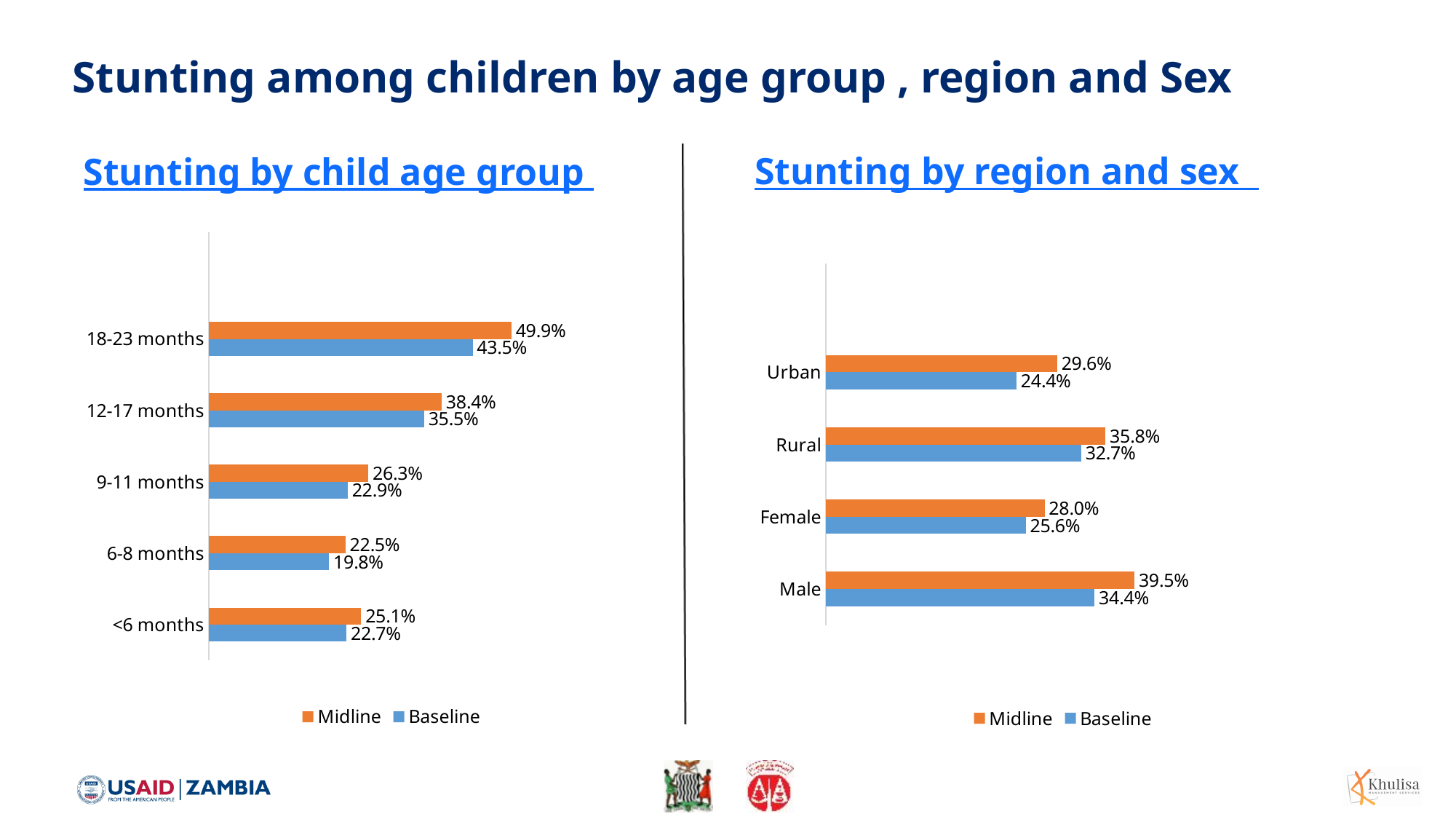
In the 'Stunting by region and sex' chart, what is the difference between the Midline and Baseline values for Male? 5.1% In the 'Stunting by region and sex' chart, what is the Midline value for Rural? 35.8% In the 'Stunting by region and sex' chart, which is larger, the Midline value for Female or the Midline value for Urban? Urban How many series does the legend of the 'Stunting by region and sex' chart list? 2 In the 'Stunting by child age group' chart, what is the Baseline value for 6-8 months? 19.8% In the 'Stunting by child age group' chart, which age group has the lowest Baseline value? 6-8 months In the 'Stunting by region and sex' chart, what is the Baseline value for Urban? 24.4% In the 'Stunting by child age group' chart, which age group has the highest Midline value? 18-23 months In the 'Stunting by child age group' chart, how many age groups are shown? 5 In the 'Stunting by child age group' chart, what is the Midline value for 18-23 months? 49.9% In the 'Stunting by child age group' chart, what is the difference between the Midline and Baseline values for 12-17 months? 2.9% In the 'Stunting by region and sex' chart, which category has the highest Midline value? Male